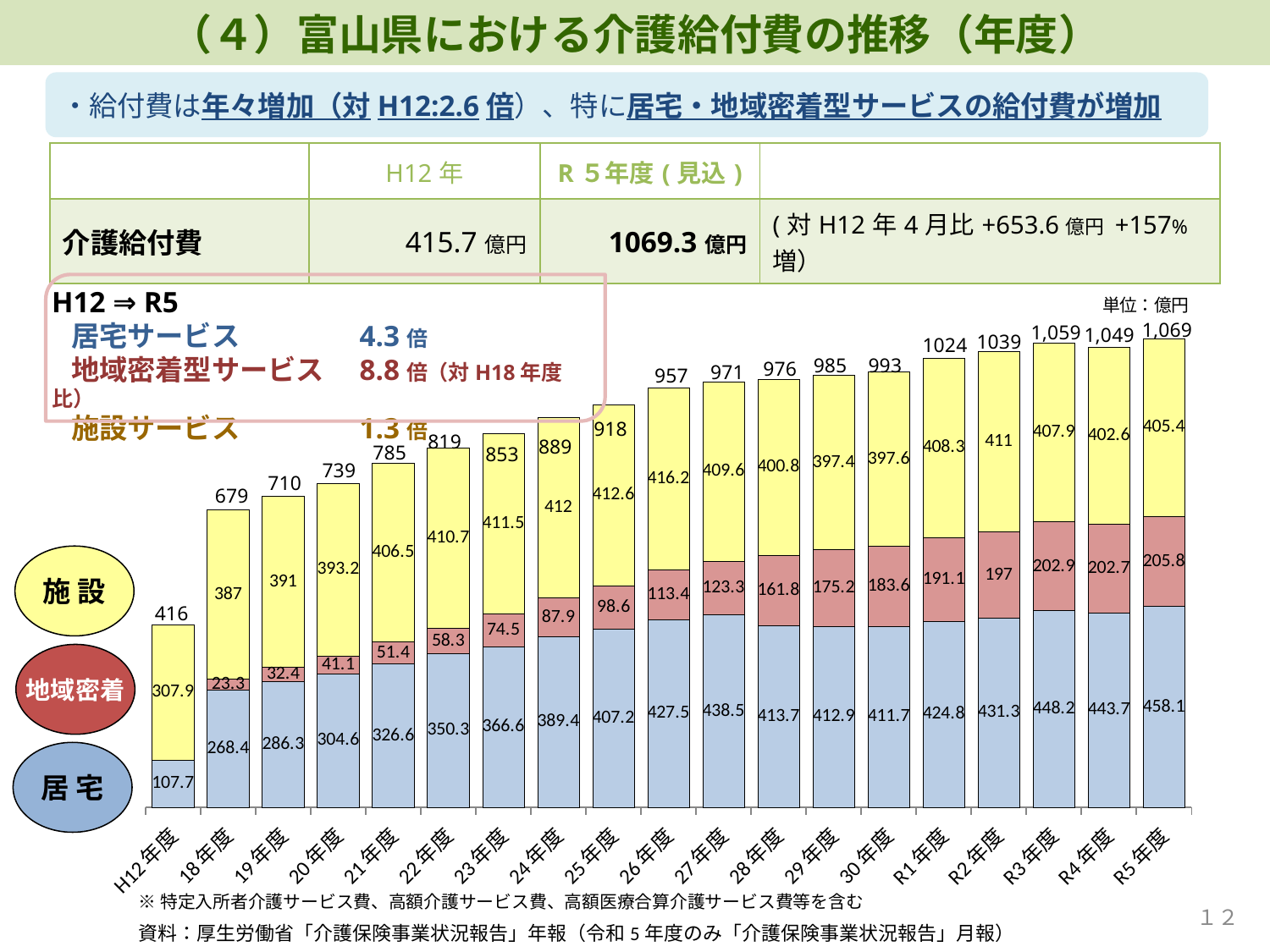
What is the 居宅 (blue) value for 26年度? 427.5 What is the difference between the total for R5年度 and the total for H12年度? 653 What kind of chart is shown on the slide? Stacked bar chart How many series (segments) does each bar in the chart contain? 3 Which fiscal year has the lowest total value in the chart? H12年度 Which fiscal year has the highest total value in the chart? R5年度 Do the total values generally rise or fall from H12年度 to R5年度? Rise What is the 施設 (yellow) value for H12年度? 307.9 Which is larger, the 居宅 value for R3年度 or the 居宅 value for R4年度? R3年度 What is the total value labeled on top of the bar for R5年度? 1,069 How many fiscal years (bars) are plotted in the chart? 19 What is the 地域密着 (red) value for 18年度? 23.3